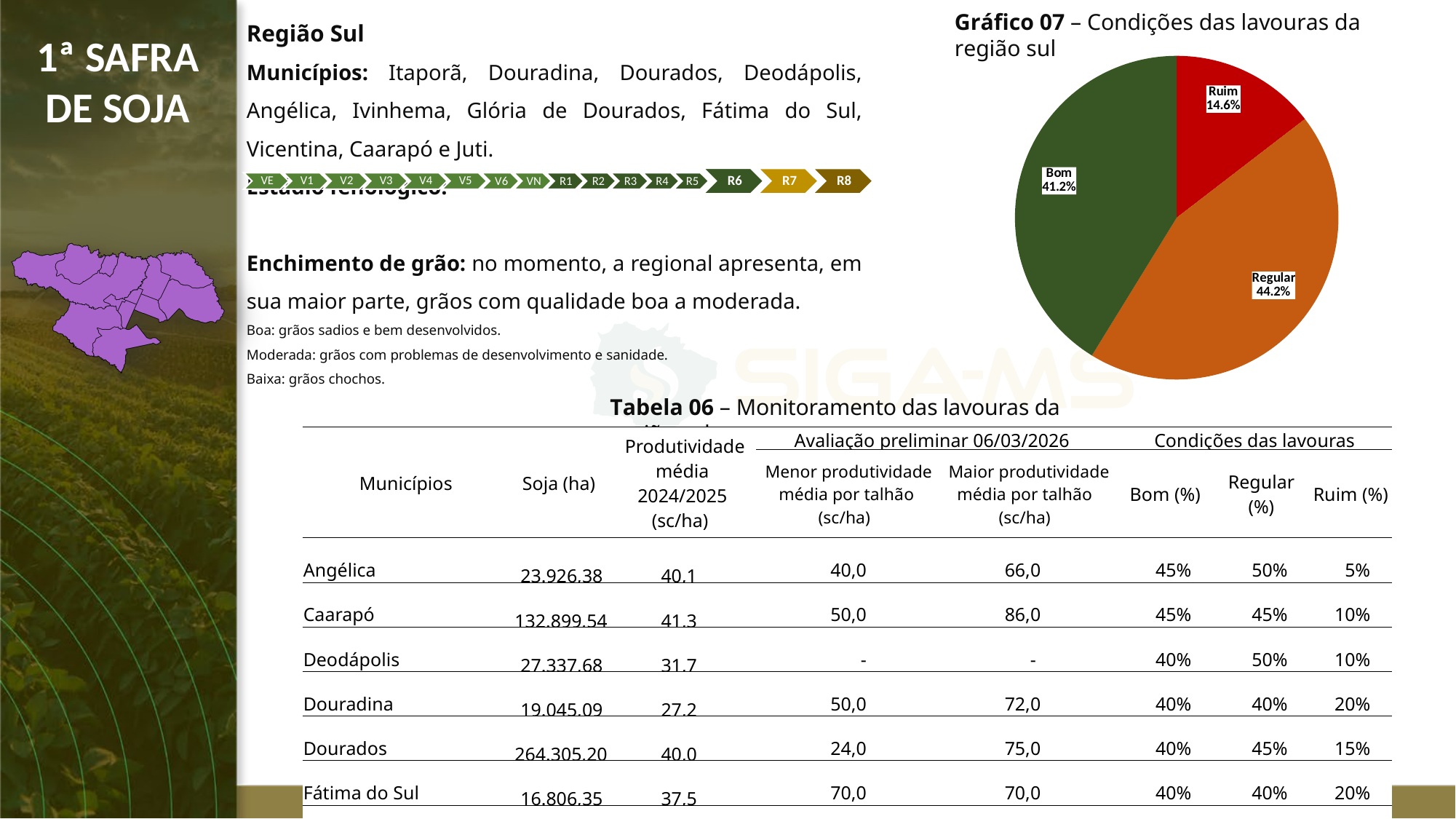
What is the title of the pie chart on the slide? Gráfico 07 – Condições das lavouras da região sul In Gráfico 07, which condition has the smallest slice? Ruim In Gráfico 07, what share of the crops is in the 'Bom' condition? 41.2% In Gráfico 07, what colour is the 'Ruim' slice? red In Gráfico 07, what share of the crops is in the 'Regular' condition? 44.2% In Gráfico 07, how many slices does the pie chart have? 3 In Gráfico 07, which condition has the largest slice? Regular What kind of chart is Gráfico 07? pie chart In Gráfico 07, what share of the crops is in the 'Ruim' condition? 14.6% In Gráfico 07, which slice is larger, 'Bom' or 'Ruim'? Bom In Gráfico 07, what is the difference in percentage points between the 'Bom' and 'Ruim' slices? 26.6 In Gráfico 07, what is the difference in percentage points between the 'Regular' and 'Bom' slices? 3.0